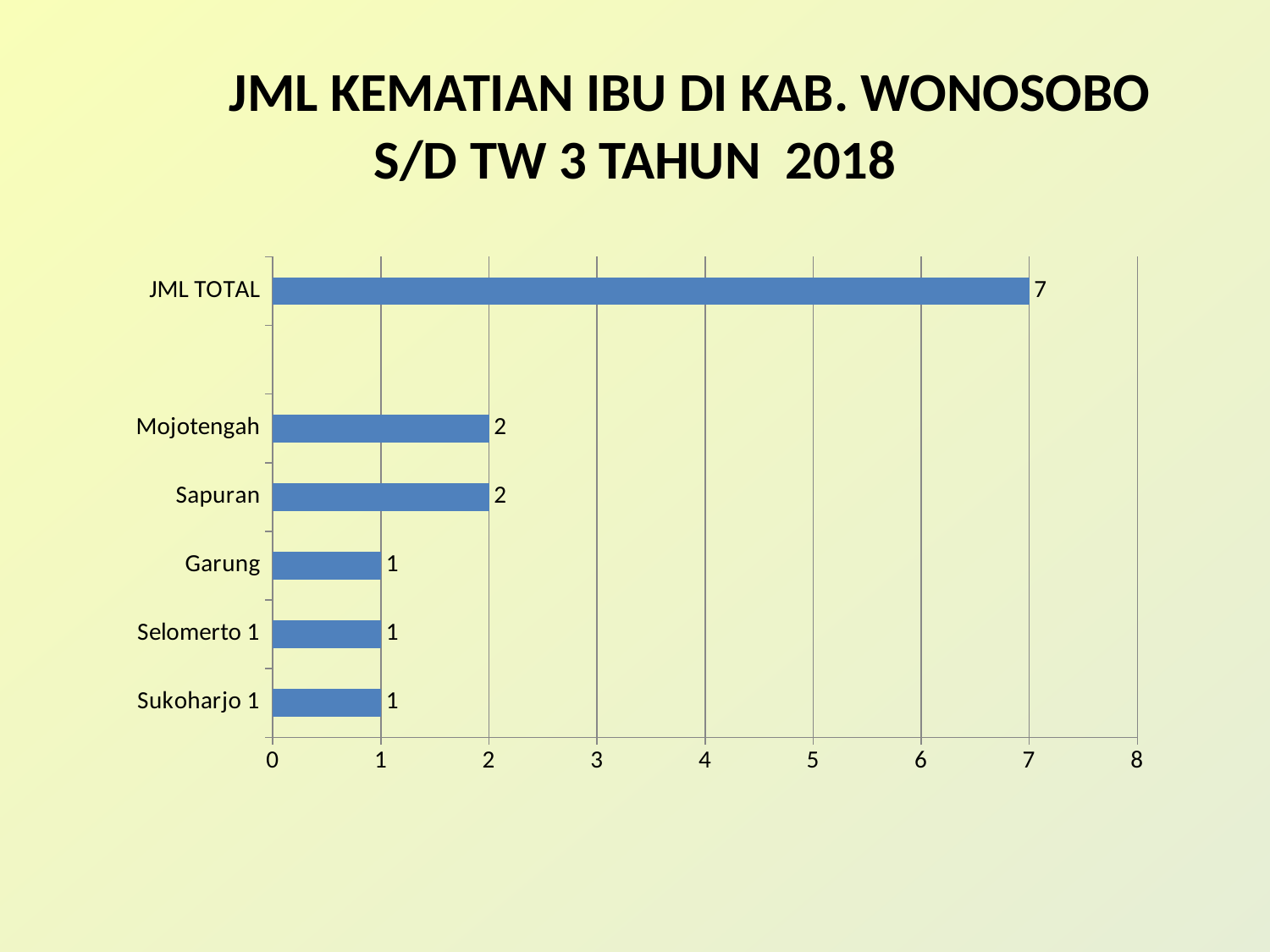
What is the value for JML TOTAL? 7 Which category has the highest value? JML TOTAL What is the value for Garung? 1 What is the value for Sukoharjo 1? 1 What is the value for Mojotengah? 2 What kind of chart is shown on the slide? bar chart What is the difference between the values for Mojotengah and Selomerto 1? 1 Is the value for JML TOTAL greater or less than 5? greater How many labelled bars are plotted in the chart? 6 Which is larger, the value for Sapuran or the value for Garung? Sapuran What is the difference between the values for JML TOTAL and Sapuran? 5 What is the title of the chart? JML KEMATIAN IBU DI KAB. WONOSOBO S/D TW 3 TAHUN 2018